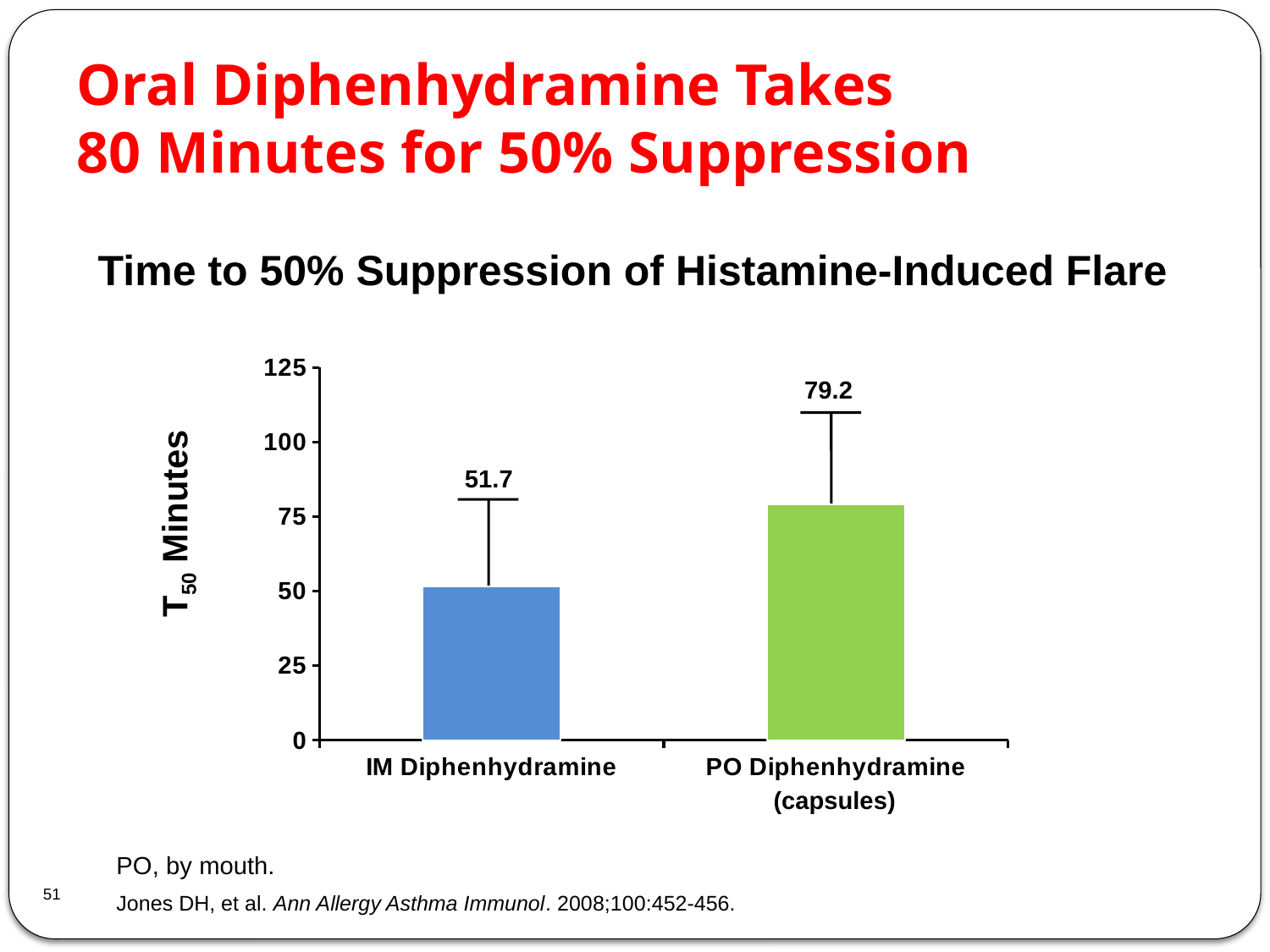
What is the difference in minutes between the PO Diphenhydramine (capsules) and IM Diphenhydramine T50 values? 27.5 How many categories are shown on the x axis of the chart? 2 What is the label of the y axis? T50 Minutes Which category has the lower T50 value? IM Diphenhydramine Is the value for PO Diphenhydramine (capsules) greater or less than 50? greater Is the T50 value larger for IM Diphenhydramine or PO Diphenhydramine (capsules)? PO Diphenhydramine (capsules) What is the title of the chart? Time to 50% Suppression of Histamine-Induced Flare What is the T50 value in minutes for PO Diphenhydramine (capsules)? 79.2 What kind of chart is shown on the slide? Bar chart Is the value for IM Diphenhydramine greater or less than 75? less What is the T50 value in minutes for IM Diphenhydramine? 51.7 Which category has the higher T50 value? PO Diphenhydramine (capsules)